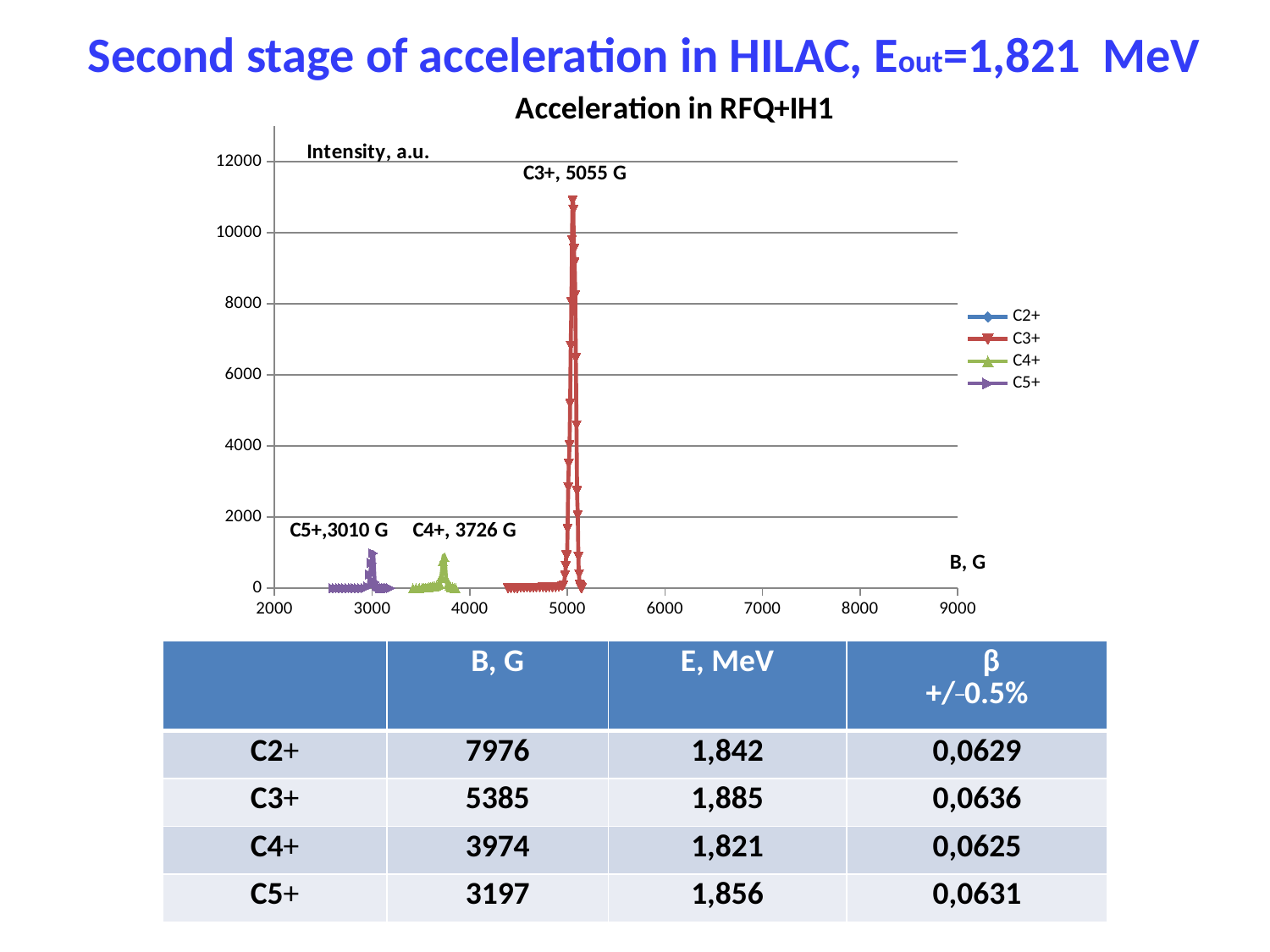
What is the title of the chart? Acceleration in RFQ+IH1 What is the label of the horizontal axis of the chart? B, G According to the chart annotation, at what magnetic field does the C5+ peak occur? 3010 G Which series peaks at a higher intensity, C3+ or C5+? C3+ What is the difference in magnetic field between the annotated C3+ peak and the annotated C4+ peak? 1329 G According to the chart annotation, at what magnetic field does the C4+ peak occur? 3726 G Is the peak intensity of the C4+ series greater or less than 2000? less Which series has the highest peak intensity in the chart? C3+ According to the chart annotation, at what magnetic field does the C3+ peak occur? 5055 G How many series does the chart legend list? 4 Is the peak intensity of the C3+ series greater or less than 10000? greater What type of chart is shown on the slide? line chart